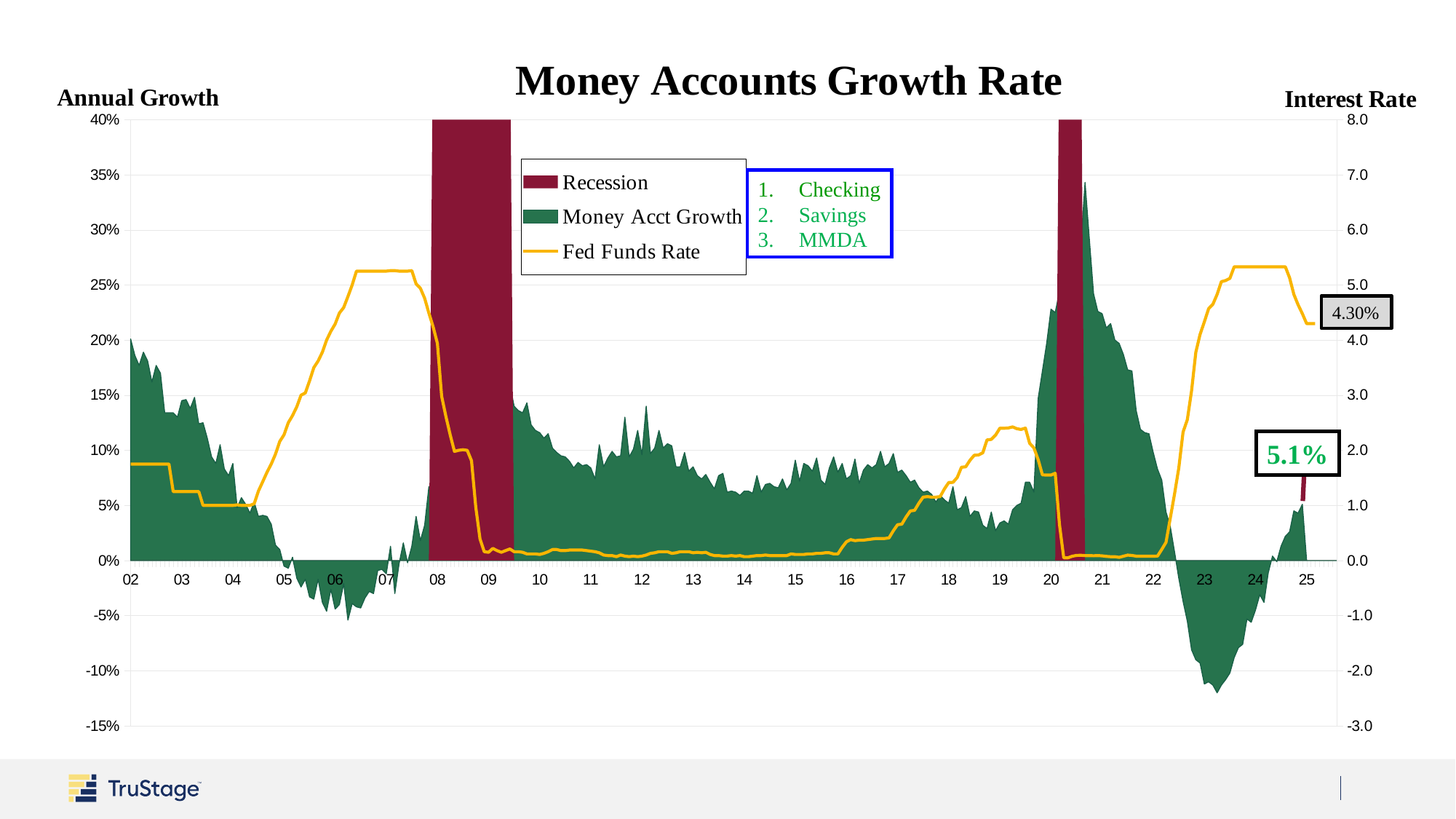
Which is higher, the Fed Funds Rate in 2007 or in 2010? 2007 Which year shows the highest Money Acct Growth on the chart? 2020 What is the latest labelled value of Money Acct Growth on the chart? 5.1% What is the latest labelled value of the Fed Funds Rate on the chart? 4.30% Is the Money Acct Growth value in 2023 greater or less than 0%? less Is the peak Money Acct Growth value around 2021 greater or less than 30%? greater How many entries does the chart legend list? 3 What is the title of the chart? Money Accounts Growth Rate What is the label of the left vertical axis? Annual Growth Is the Fed Funds Rate in 2010 greater or less than 1.0? less How many recession periods are shaded on the chart? 2 Does the Fed Funds Rate rise or fall between 2022 and 2023? rise